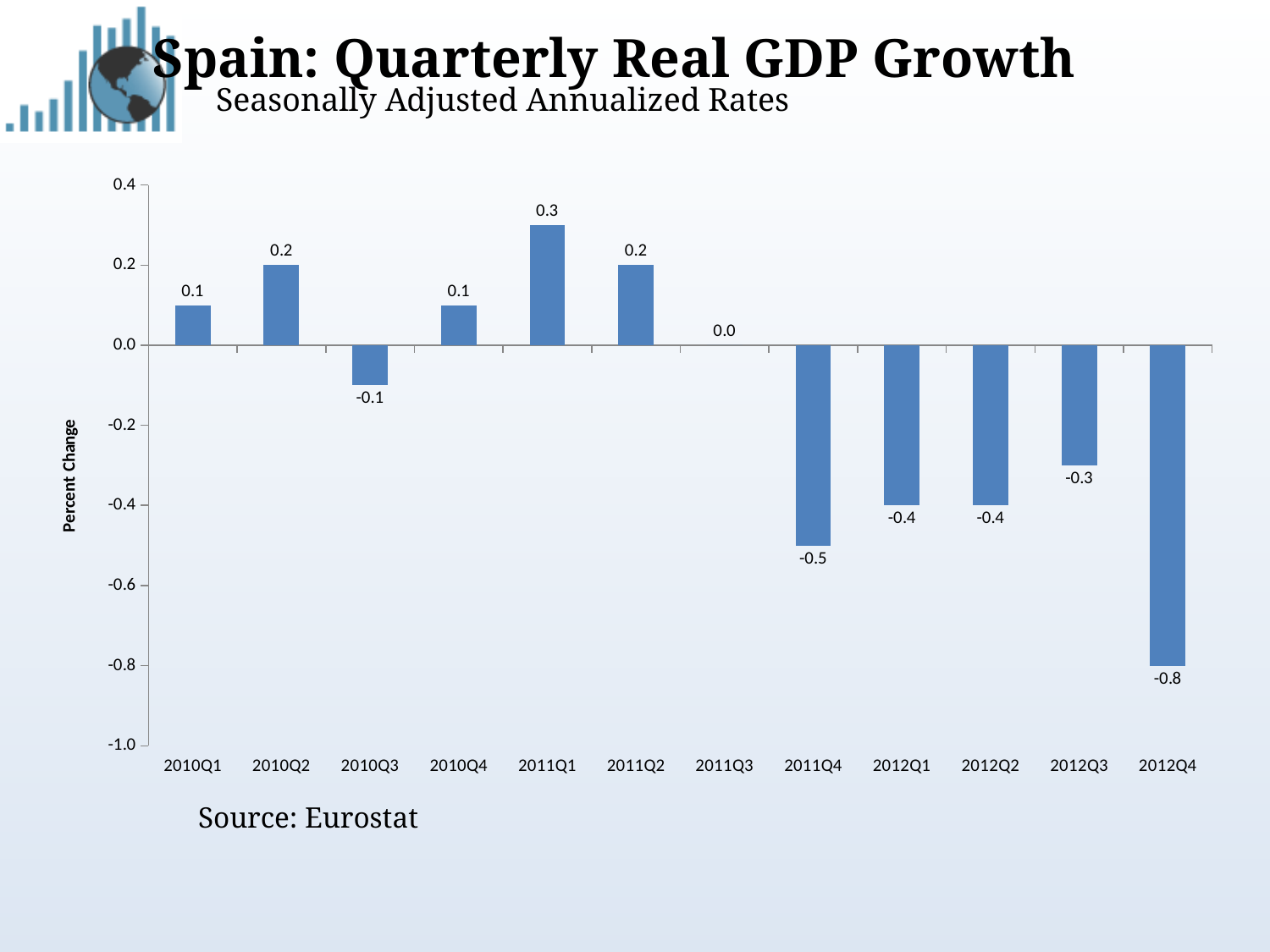
What is the value for 2011Q1? 0.3 What is the value for 2010Q3? -0.1 What is the difference between the values for 2011Q1 and 2012Q4? 1.1 How many quarters are shown on the x axis? 12 Do the values generally rise or fall from 2011Q2 to 2012Q4? Fall What is the label of the y axis? Percent Change What is the value for 2011Q3? 0.0 Which quarter has the lowest value? 2012Q4 What is the value for 2012Q4? -0.8 Which quarter has the highest value? 2011Q1 What kind of chart is this? Bar chart Which is larger, the value for 2010Q2 or the value for 2011Q4? 2010Q2